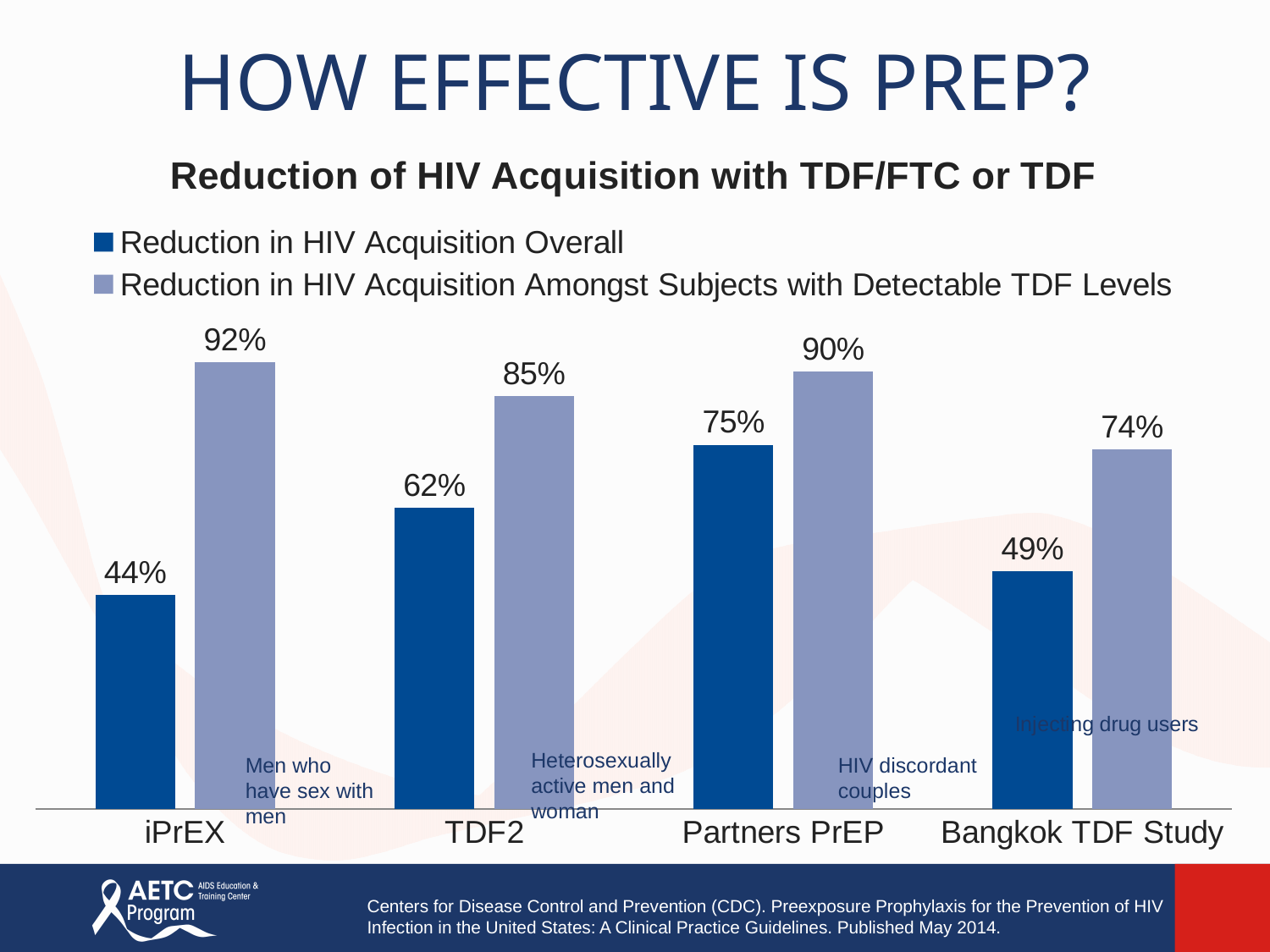
How many studies are shown on the x axis? 4 Which study has the highest Reduction in HIV Acquisition Overall? Partners PrEP Which study has the lowest Reduction in HIV Acquisition Amongst Subjects with Detectable TDF Levels? Bangkok TDF Study What is the difference between the two values shown for iPrEX? 48% What is the Reduction in HIV Acquisition Overall for iPrEX? 44% What is the Reduction in HIV Acquisition Amongst Subjects with Detectable TDF Levels for TDF2? 85% How many series does the legend list? 2 What kind of chart is shown on the slide? Bar chart Which is larger: the overall reduction for TDF2 or the overall reduction for the Bangkok TDF Study? TDF2 What is the Reduction in HIV Acquisition Overall for Partners PrEP? 75% What is the Reduction in HIV Acquisition Amongst Subjects with Detectable TDF Levels for the Bangkok TDF Study? 74% What is the title of the chart? Reduction of HIV Acquisition with TDF/FTC or TDF